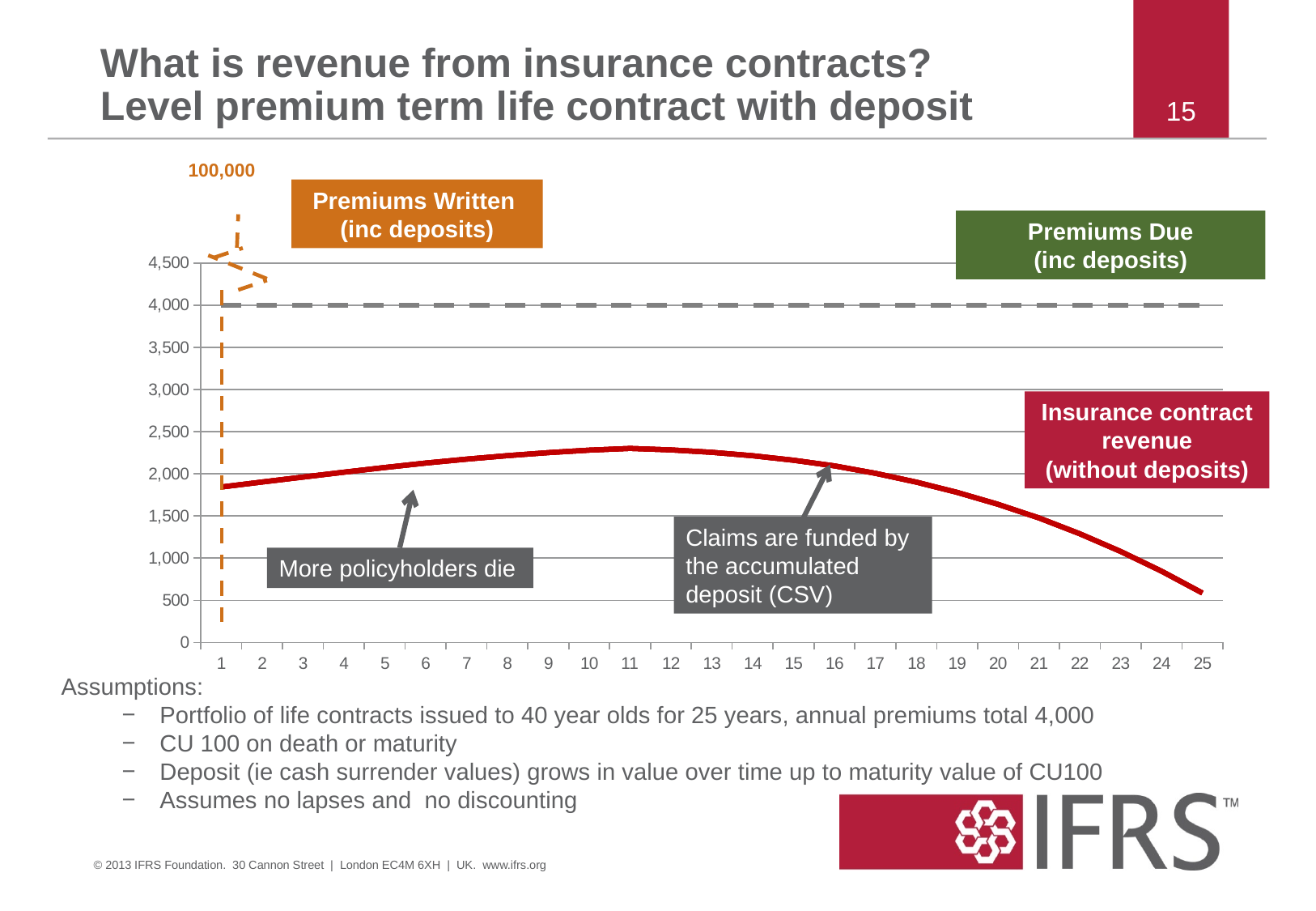
What is the value of Premiums Due (inc deposits) each year? 4,000 Is the Insurance contract revenue (without deposits) in year 1 greater or less than 1,500? greater Is the Insurance contract revenue (without deposits) in year 25 greater or less than 1,000? less Does the Insurance contract revenue (without deposits) rise or fall from year 15 to year 25? fall How many years are shown along the x axis of the chart? 25 Is the Insurance contract revenue (without deposits) in year 11 greater or less than 2,500? less Which series is drawn as the grey dashed horizontal line? Premiums Due (inc deposits) What colour is the Insurance contract revenue (without deposits) line? red In year 25, which is larger: Premiums Due (inc deposits) or Insurance contract revenue (without deposits)? Premiums Due (inc deposits) What is the value of Premiums Written (inc deposits) in year 1? 100,000 What kind of chart is shown on the slide? line chart